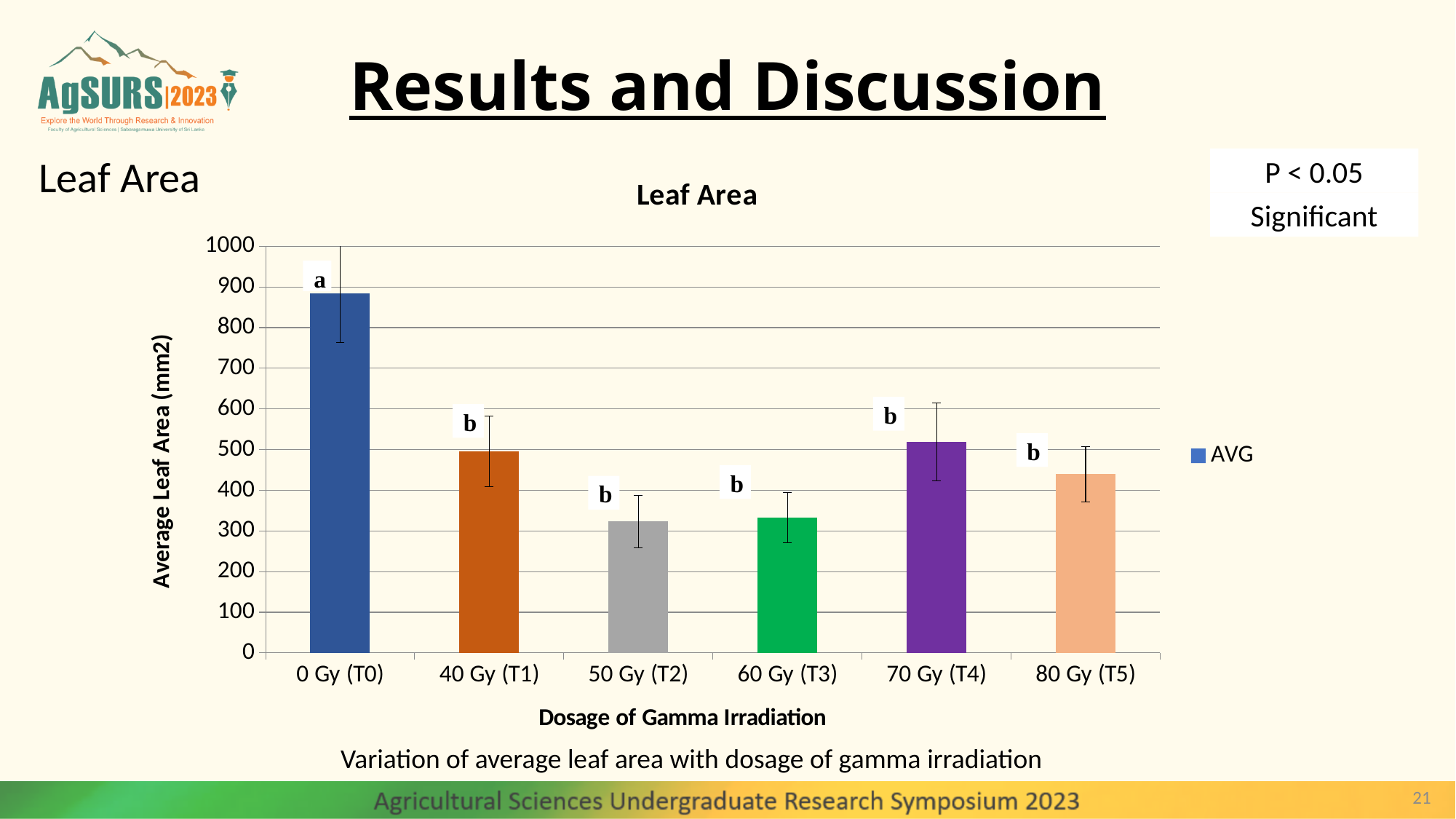
Which has a larger average leaf area, 70 Gy (T4) or 80 Gy (T5)? 70 Gy (T4) How many series does the chart's legend list? 1 What is the name of the series listed in the chart's legend? AVG Which has a larger average leaf area, 40 Gy (T1) or 50 Gy (T2)? 40 Gy (T1) What kind of chart is shown on the slide? bar chart What is the label on the y axis of the chart? Average Leaf Area (mm2) Is the average leaf area for 0 Gy (T0) greater or less than 800? greater Is the average leaf area for 80 Gy (T5) greater or less than 500? less Which dosage has the highest average leaf area? 0 Gy (T0) Is the average leaf area for 40 Gy (T1) greater or less than 400? greater How many dosage categories are shown on the x axis of the chart? 6